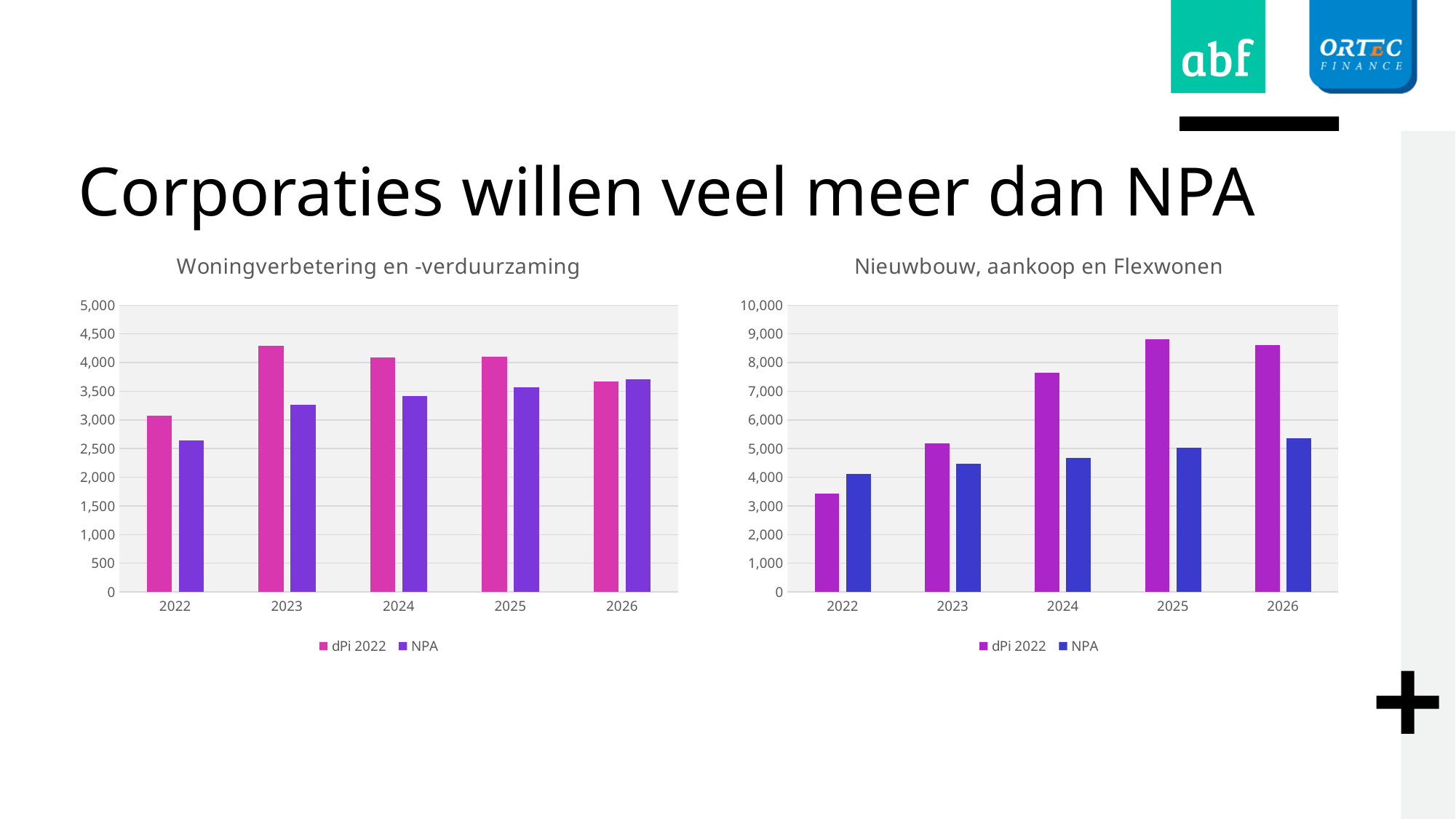
In the chart titled 'Woningverbetering en -verduurzaming', is the NPA value for 2022 greater or less than 3,000? less In the chart titled 'Nieuwbouw, aankoop en Flexwonen', which is larger for 2022, dPi 2022 or NPA? NPA In the chart titled 'Woningverbetering en -verduurzaming', do the NPA values rise or fall from 2022 to 2026? rise In the chart titled 'Woningverbetering en -verduurzaming', which year has the highest dPi 2022 value? 2023 In the chart titled 'Woningverbetering en -verduurzaming', which year has the lowest NPA value? 2022 In the chart titled 'Nieuwbouw, aankoop en Flexwonen', which year has the highest dPi 2022 value? 2025 In the chart titled 'Nieuwbouw, aankoop en Flexwonen', is the NPA value for 2026 greater or less than 5,000? greater How many years are shown on the x axis of the chart titled 'Woningverbetering en -verduurzaming'? 5 In the chart titled 'Nieuwbouw, aankoop en Flexwonen', is the dPi 2022 value for 2024 greater or less than 7,000? greater In the chart titled 'Nieuwbouw, aankoop en Flexwonen', do the NPA values rise or fall from 2022 to 2026? rise How many series does the legend of the chart titled 'Nieuwbouw, aankoop en Flexwonen' list? 2